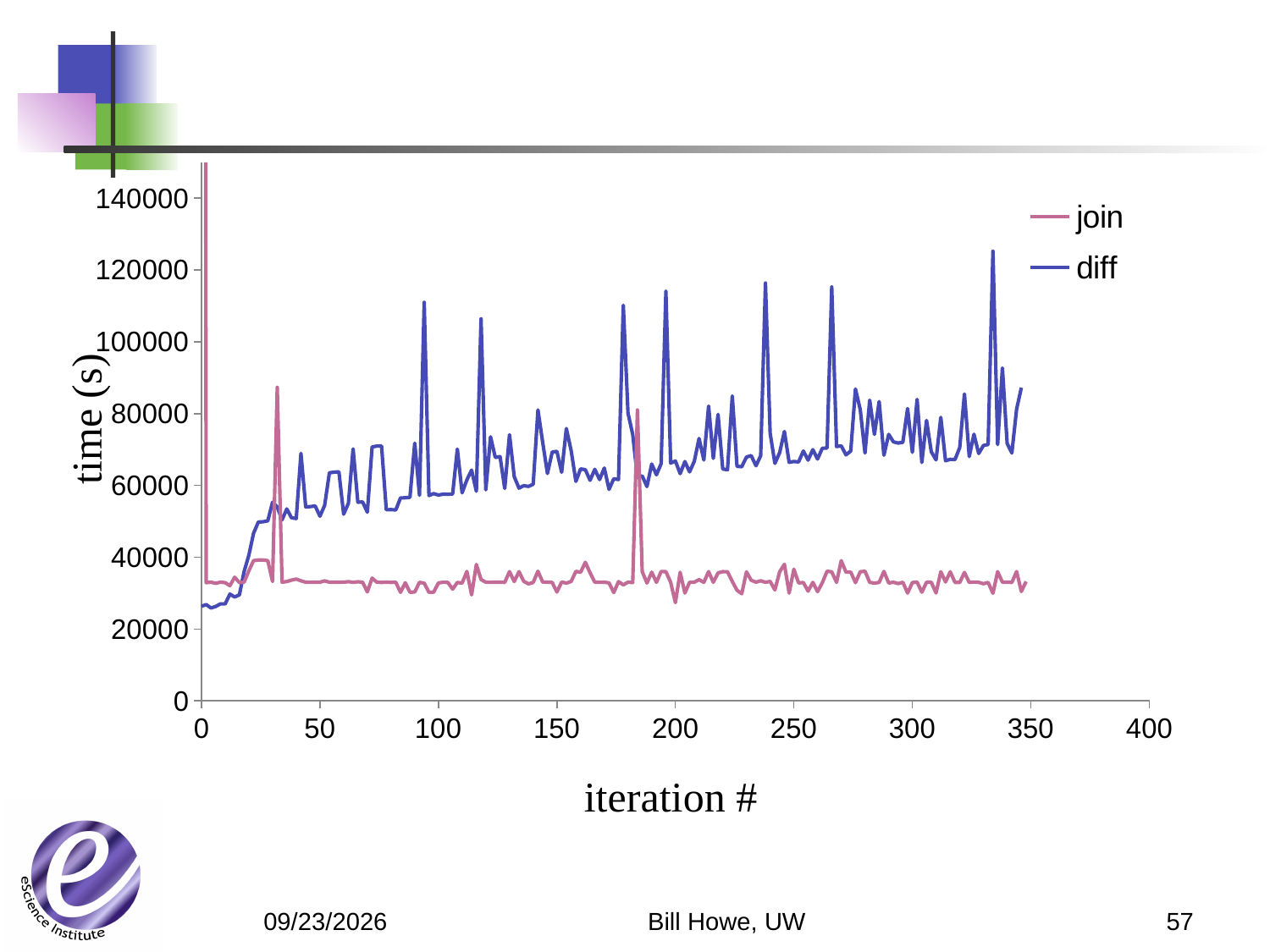
What kind of chart is shown on the slide? line chart Which series shows the highest value anywhere on the chart? join How many series does the legend list? 2 Does the diff series generally rise or fall as the iteration number increases? rise Is the value for diff at iteration 300 greater or less than 60000? greater At iteration 100, which series has the lower value, join or diff? join What is the label on the vertical axis? time (s) Is the value for join at iteration 300 greater or less than 20000? greater Is the value for diff at iteration 50 greater or less than 40000? greater At iteration 250, which series has the higher value, join or diff? diff What are the two series named in the legend? join and diff